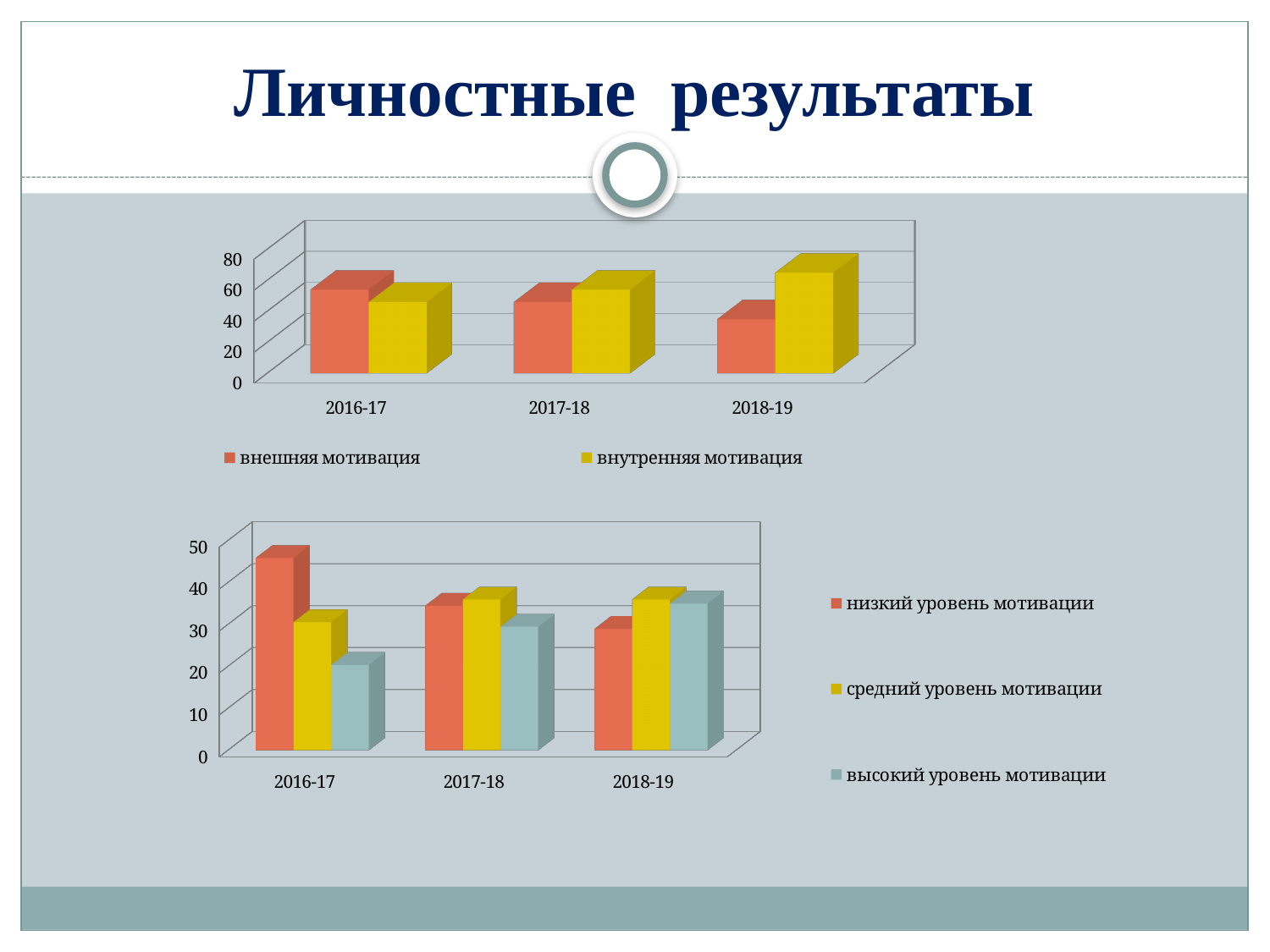
In the bottom chart, in which year is высокий уровень мотивации lowest? 2016-17 How many series does the legend of the top chart list? 2 In the top chart, does the value for внешняя мотивация rise or fall from 2016-17 to 2018-19? fall What kind of chart is the top chart on the slide? bar chart In the top chart, does the value for внутренняя мотивация rise or fall from 2016-17 to 2018-19? rise How many categories are shown on the x axis of the top chart? 3 In the bottom chart, in which year is низкий уровень мотивации highest? 2016-17 In the top chart, which is larger in 2018-19: внешняя мотивация or внутренняя мотивация? внутренняя мотивация In the bottom chart, is the value for высокий уровень мотивации in 2016-17 greater or less than 30? less In the top chart, is the value for внутренняя мотивация in 2018-19 greater or less than 60? greater How many series does the legend of the bottom chart list? 3